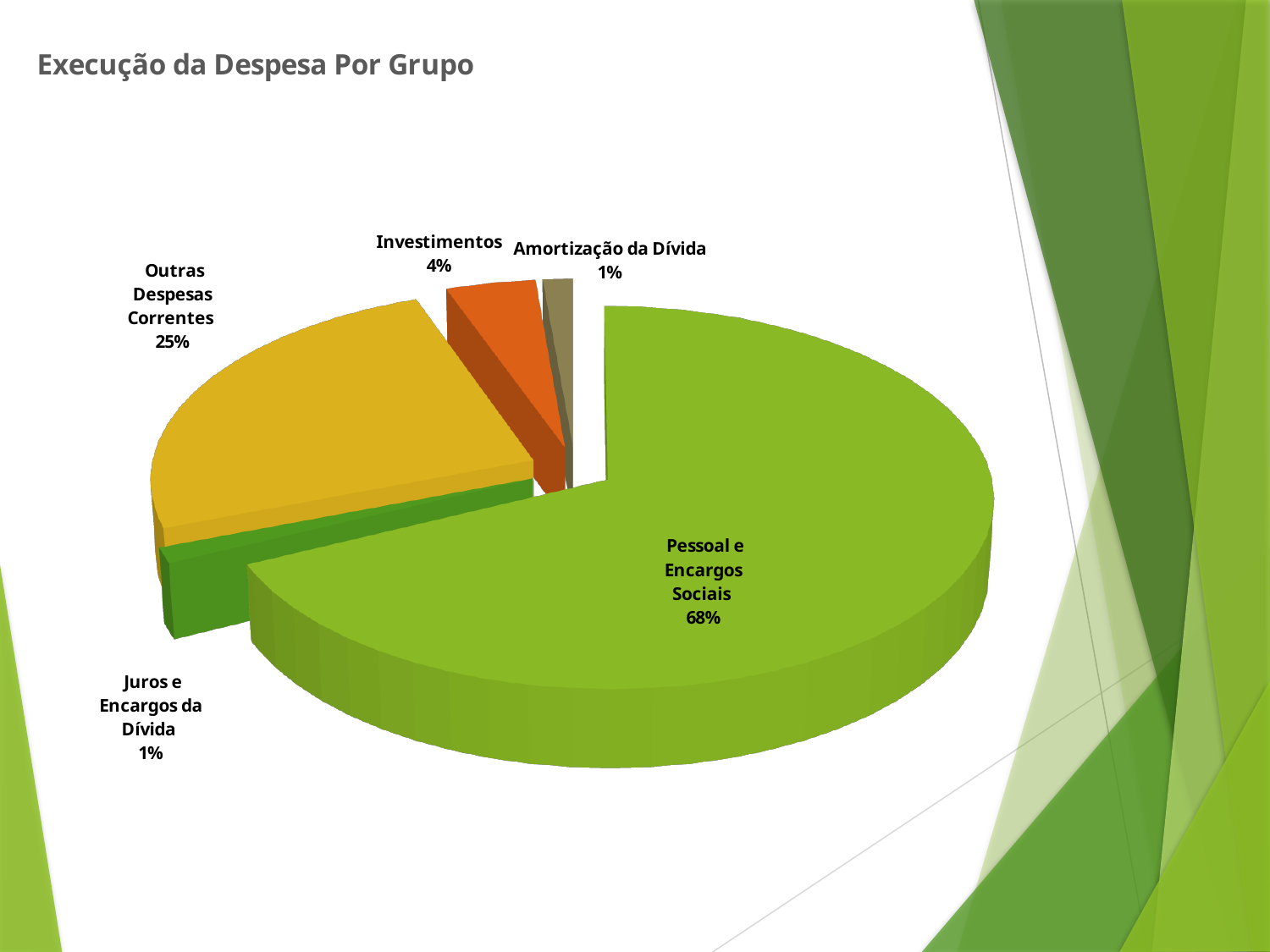
What kind of chart is shown on the slide? Pie chart What is the title of the slide? Execução da Despesa Por Grupo What is the value shown for Investimentos? 4% What is the value shown for Amortização da Dívida? 1% What is the difference in percentage points between Outras Despesas Correntes and Investimentos? 21 How many categories are shown in the pie chart? 5 Which category has the largest share of the pie? Pessoal e Encargos Sociais Which is larger, Investimentos or Amortização da Dívida? Investimentos What share of the pie does Pessoal e Encargos Sociais represent? 68% What is the value shown for Juros e Encargos da Dívida? 1% What share of the pie does Outras Despesas Correntes represent? 25% What is the difference in percentage points between Pessoal e Encargos Sociais and Outras Despesas Correntes? 43